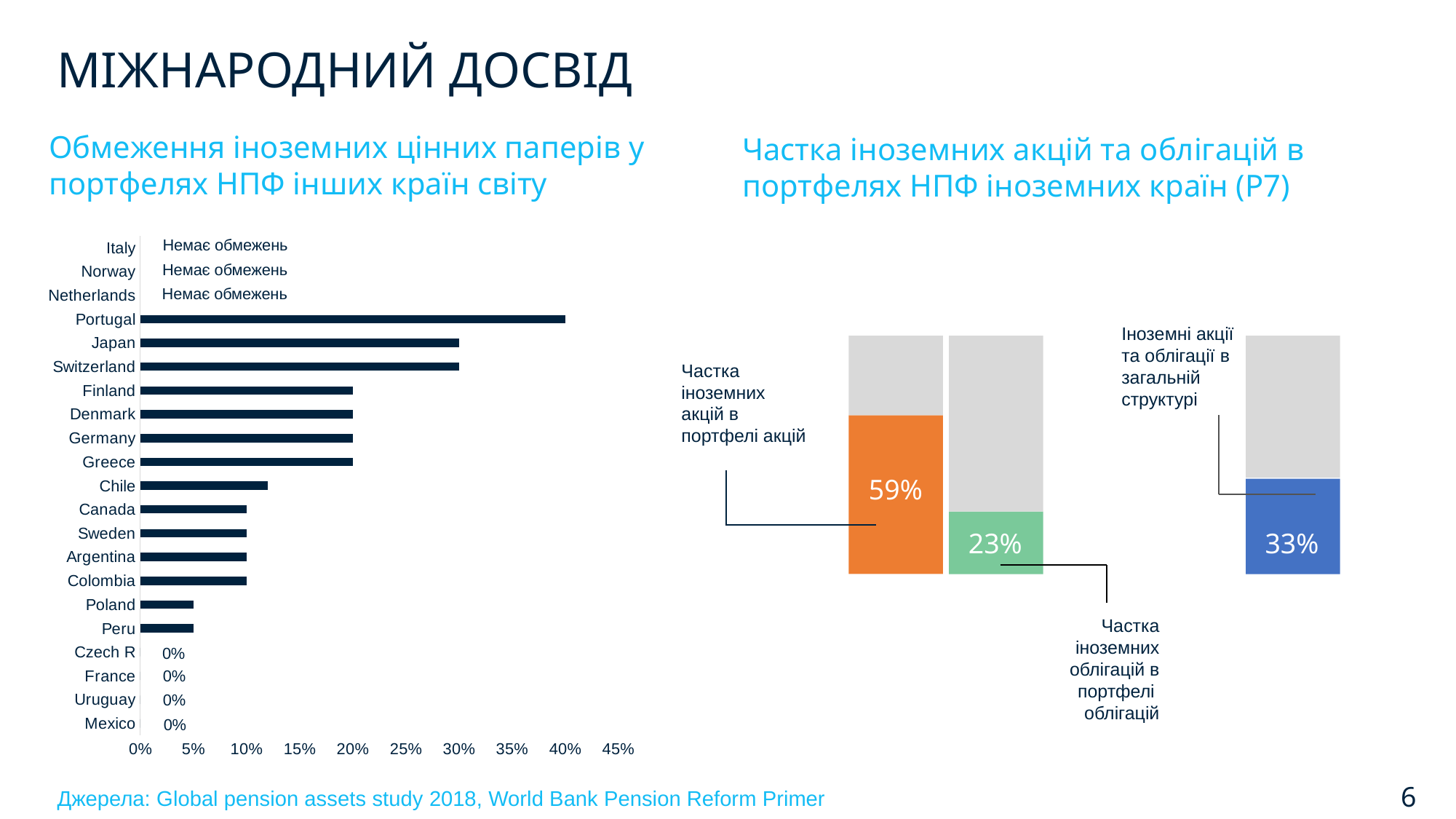
On the right chart, what is the difference between the foreign equities share (59%) and the foreign bonds share (23%)? 36% What kind of chart is the left chart? bar chart On the left chart, which country has the highest limit shown as a bar? Portugal On the left chart, is the value for Poland greater or less than 10%? less On the left chart, which is larger, the value for Finland or the value for Canada? Finland On the left chart, what is the value for Portugal? 40% On the right chart, what is the share of foreign equities in the equity portfolio (Частка іноземних акцій в портфелі акцій)? 59% On the right chart, what is the share of foreign bonds in the bond portfolio (Частка іноземних облігацій в портфелі облігацій)? 23% On the left chart, what text is shown next to Italy, Norway and Netherlands instead of a bar? Немає обмежень On the left chart, what value is shown for Czech R? 0% On the left chart, is the value for Chile greater or less than 10%? greater On the left chart, what is the value for Japan? 30%